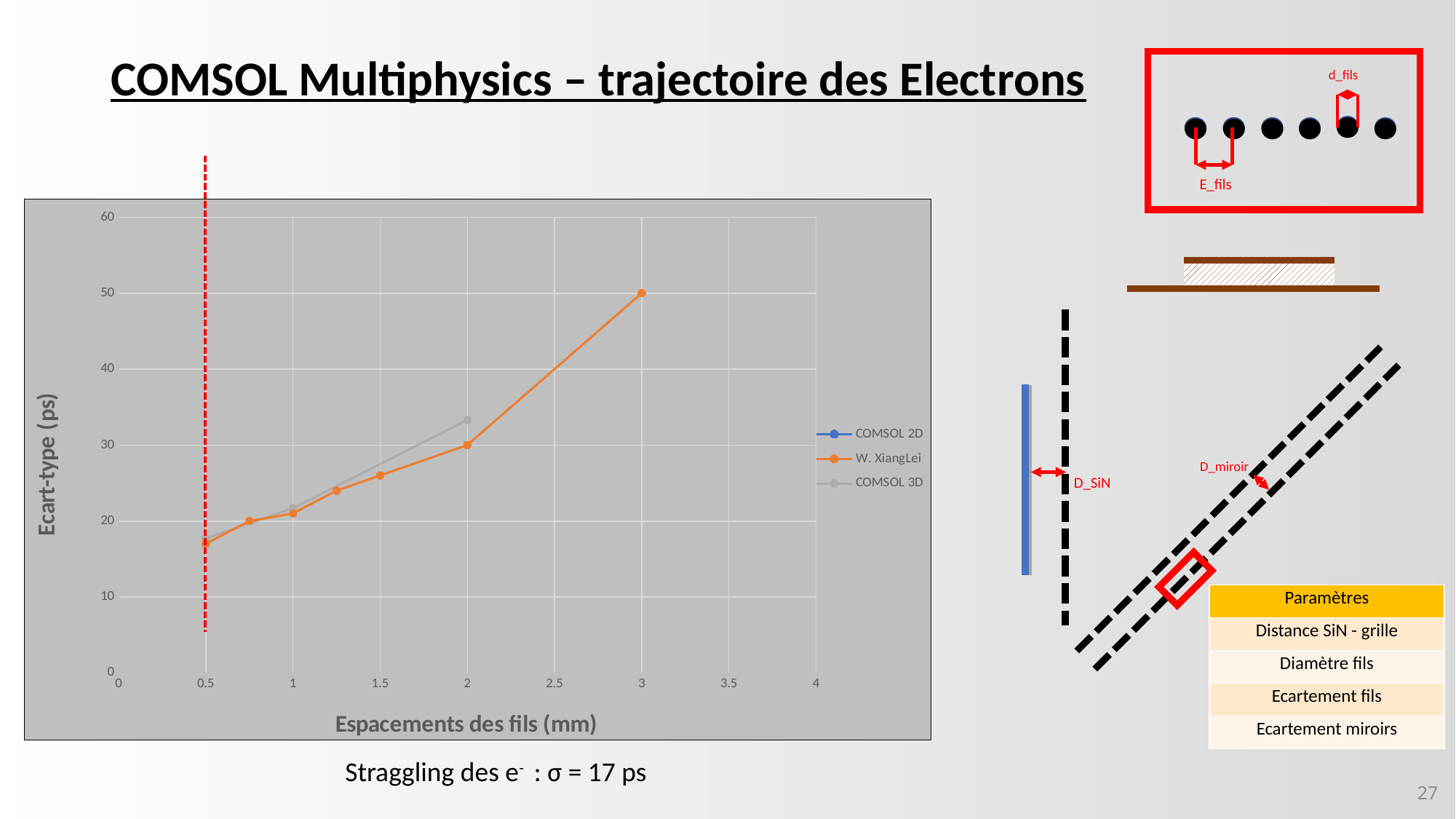
What is the value of the W. XiangLei series at an x value of 3 mm? 50 How many series does the chart legend list? 3 What is the value of the W. XiangLei series at an x value of 2 mm? 30 Is the value of the COMSOL 3D series at 2 mm greater or less than 30? greater What kind of chart is shown on the slide? line chart Does the W. XiangLei series rise or fall as the wire spacing increases along the x axis? rise At 2 mm, which series has the larger value, COMSOL 3D or W. XiangLei? COMSOL 3D At which x value does the W. XiangLei series reach its highest value? 3 What are the three series named in the chart legend? COMSOL 2D, W. XiangLei, COMSOL 3D How many data points are plotted for the W. XiangLei series? 7 Is the value of the W. XiangLei series at 0.5 mm greater or less than 20? less What is the title of the chart's x axis? Espacements des fils (mm)